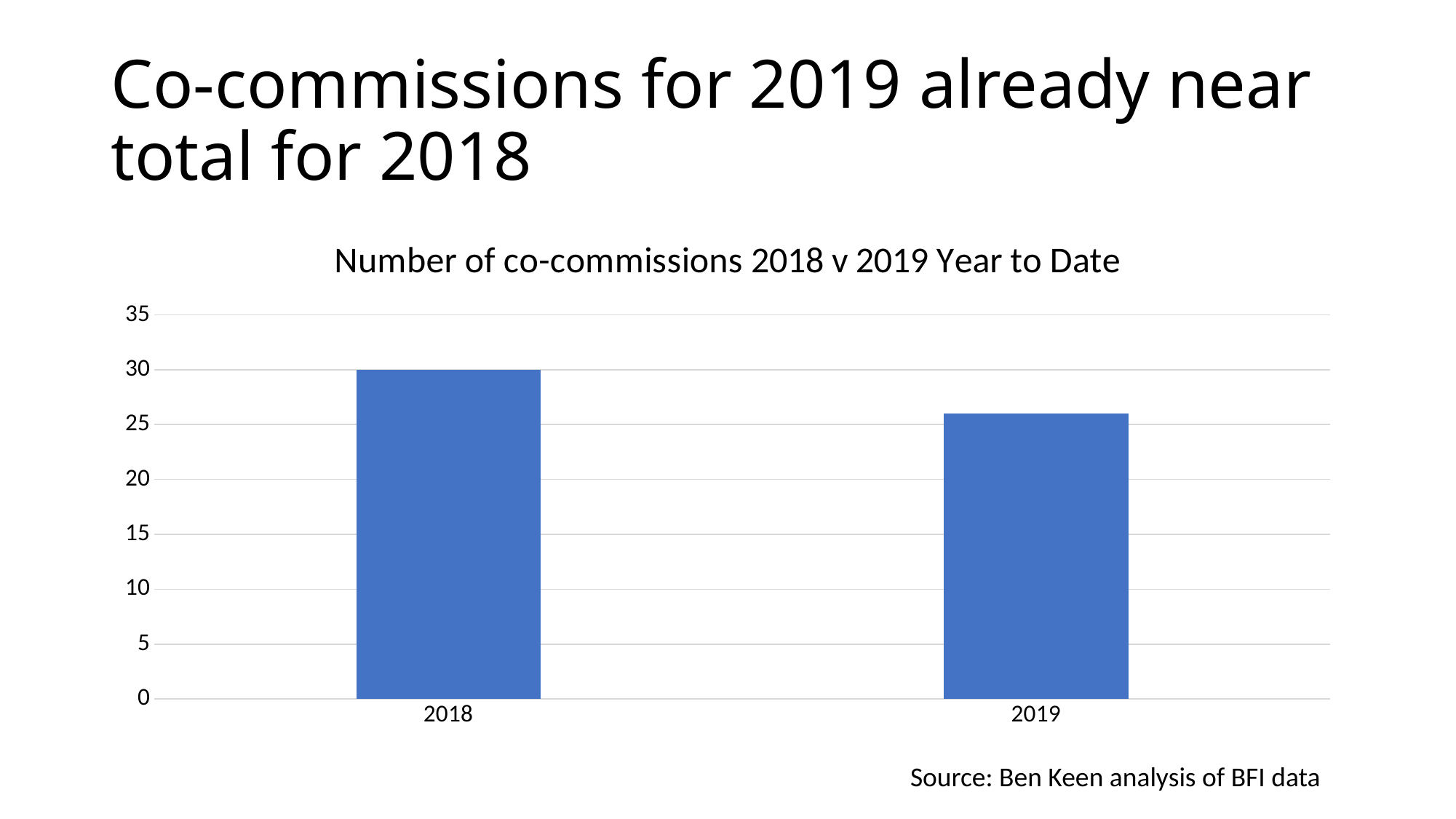
What is the number of co-commissions for 2018 according to the chart? 30 What is the title of the chart? Number of co-commissions 2018 v 2019 Year to Date Which bar is taller, 2018 or 2019? 2018 How many categories are plotted on the x axis of the chart? 2 Do the values rise or fall from 2018 to 2019 along the x axis? fall Is the value for 2019 greater or less than 30? less What source is cited for the chart data? Ben Keen analysis of BFI data Which year has the highest number of co-commissions in the chart? 2018 Which year has the lowest number of co-commissions in the chart? 2019 What kind of chart is shown on the slide? bar chart Is the value for 2018 greater or less than 20? greater Is the value for 2019 greater or less than 25? greater